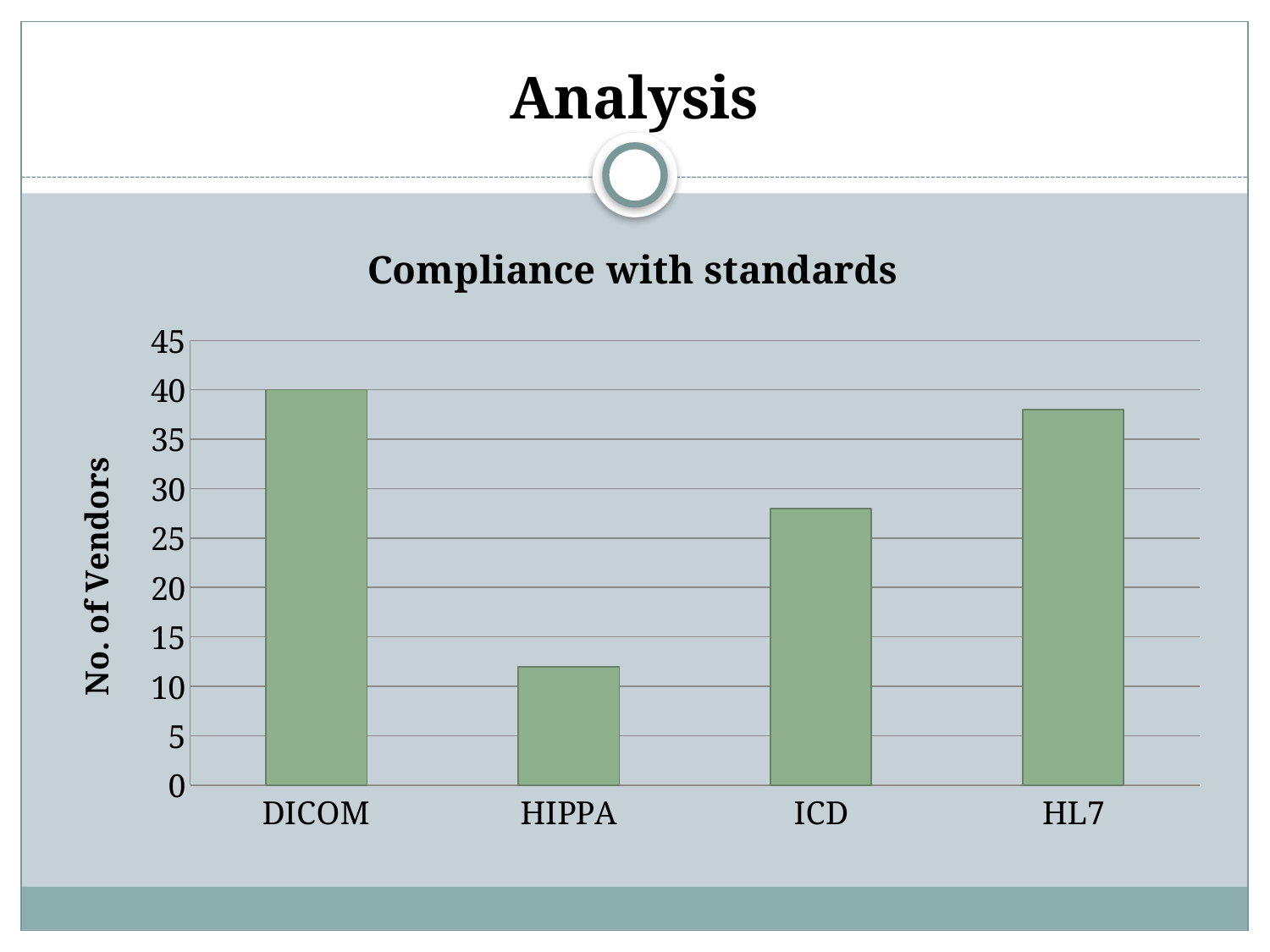
Is the value for HL7 greater or less than 35? greater Is the value for HIPPA greater or less than 15? less What type of chart is shown on the slide? bar chart Which has more vendors, ICD or HL7? HL7 Which standard has the lowest number of vendors? HIPPA Which has more vendors, HIPPA or ICD? ICD How many standards (categories) are shown on the x axis? 4 What is the title of the chart? Compliance with standards Is the value for ICD greater or less than 25? greater What is the label of the vertical axis? No. of Vendors Which standard has the highest number of vendors? DICOM What is the number of vendors for DICOM? 40